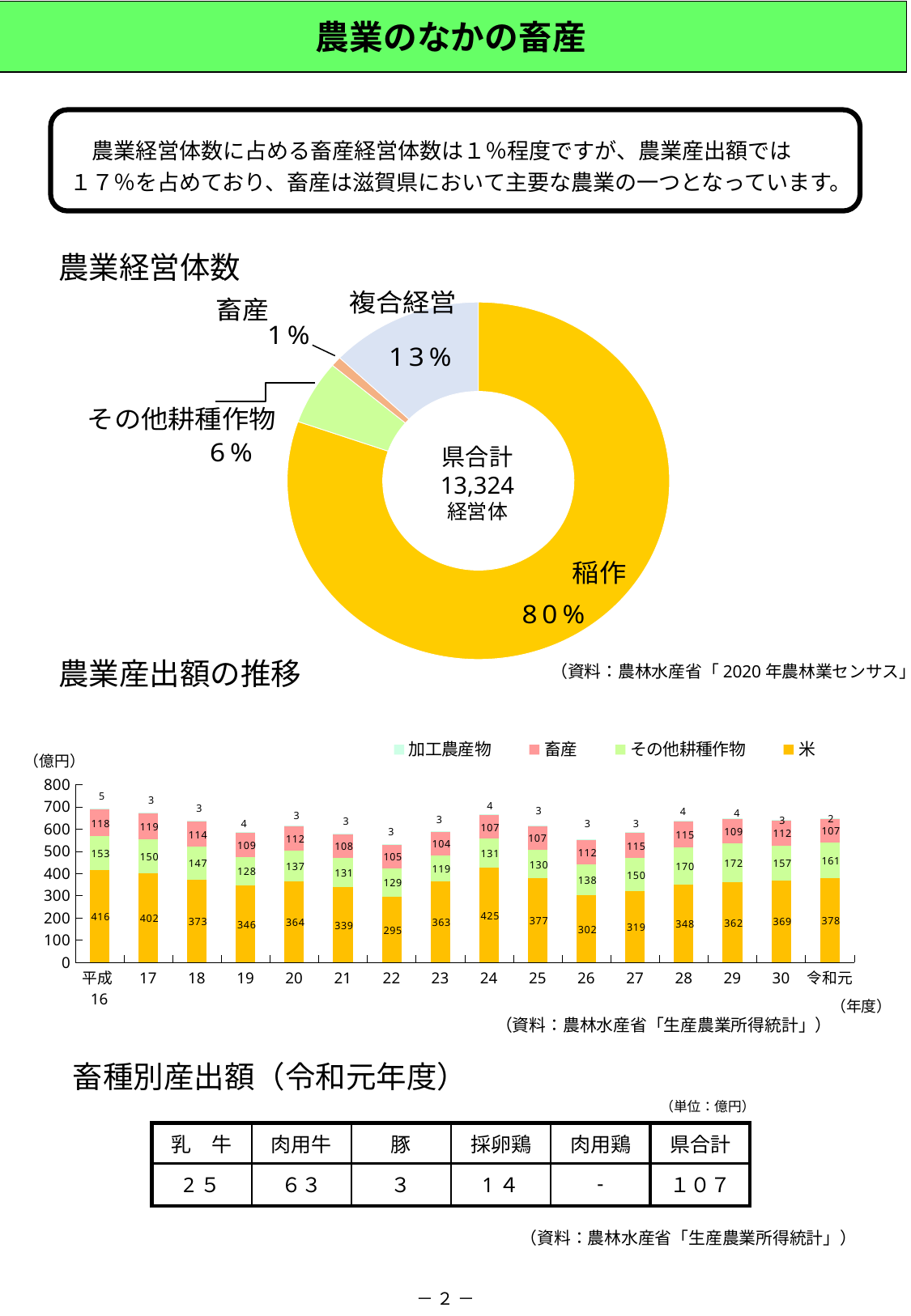
In the 農業産出額の推移 chart, what is the value of 米 for 平成24? 425 In the 農業経営体数 donut chart, what is the 県合計 shown in the centre? 13,324 経営体 In the 農業産出額の推移 chart, how many series does the legend list? 4 What kind of chart is the 農業産出額の推移 chart? Stacked bar chart In the 農業産出額の推移 chart, which year has the lowest 米 value? 平成22 In the 農業経営体数 donut chart, how many categories are shown? 4 In the 農業経営体数 donut chart, which category has the smallest share? 畜産 In the 農業経営体数 donut chart, what share is 畜産? 1% In the 農業産出額の推移 chart, what is the total of the stacked bar for 平成22? 532 In the 農業経営体数 donut chart, what share is 稲作? 80% In the 農業産出額の推移 chart, what is the difference between the 米 values for 平成24 and 平成22? 130 In the 農業産出額の推移 chart, what is the value of 畜産 for 令和元? 107